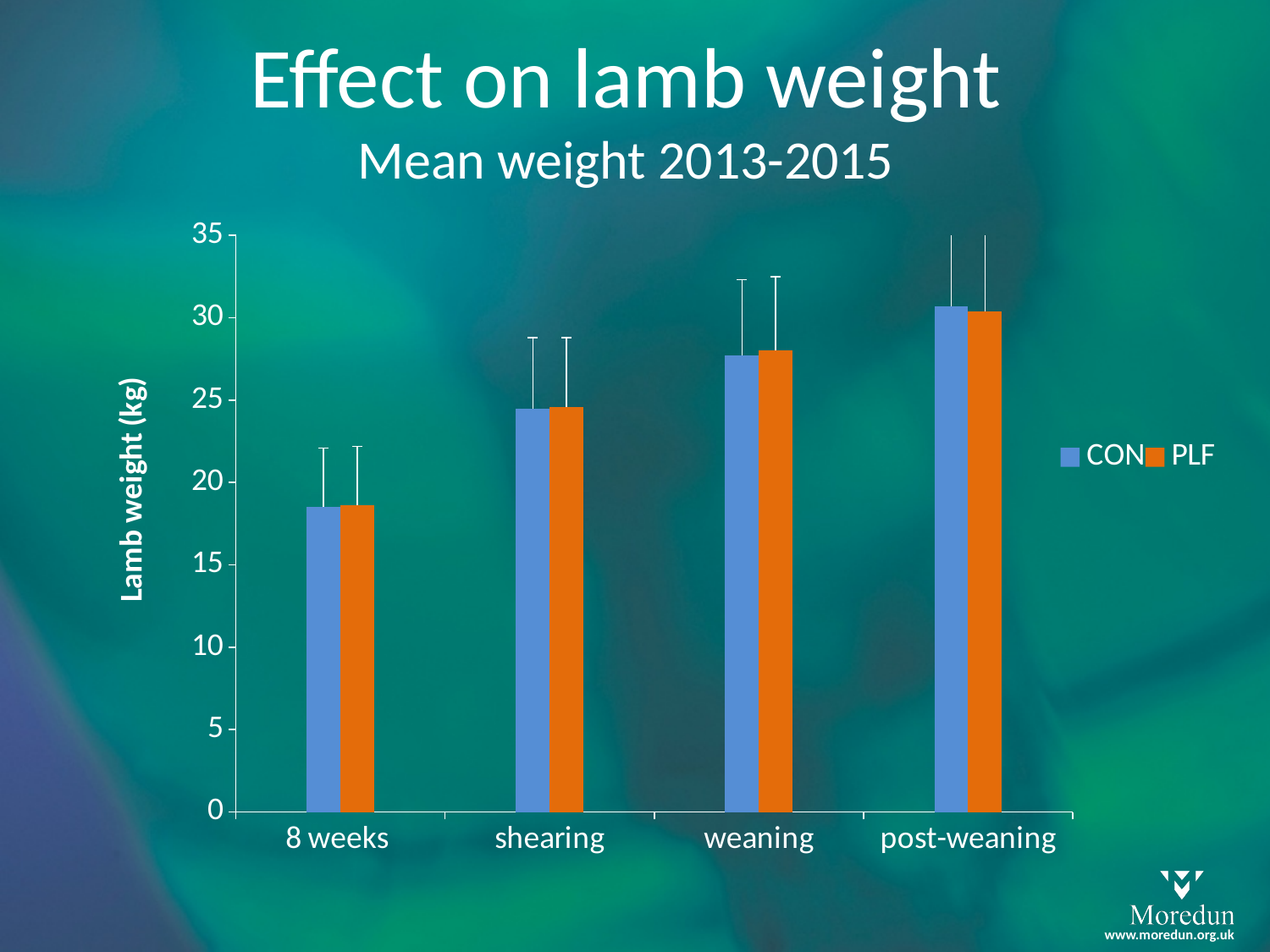
Do the lamb weights rise or fall from 8 weeks to post-weaning? rise How many series does the legend list? 2 Which category has the highest lamb weight for the CON series? post-weaning Is the CON value at 8 weeks greater or less than 20? less Is the CON value at weaning greater or less than 25? greater How many categories are shown on the x axis? 4 What is the label of the y axis? Lamb weight (kg) Which category has the lowest lamb weight for the PLF series? 8 weeks What kind of chart is shown on the slide? bar chart Which is larger, the PLF value at shearing or the PLF value at weaning? weaning Which colour represents the PLF series in the legend? orange